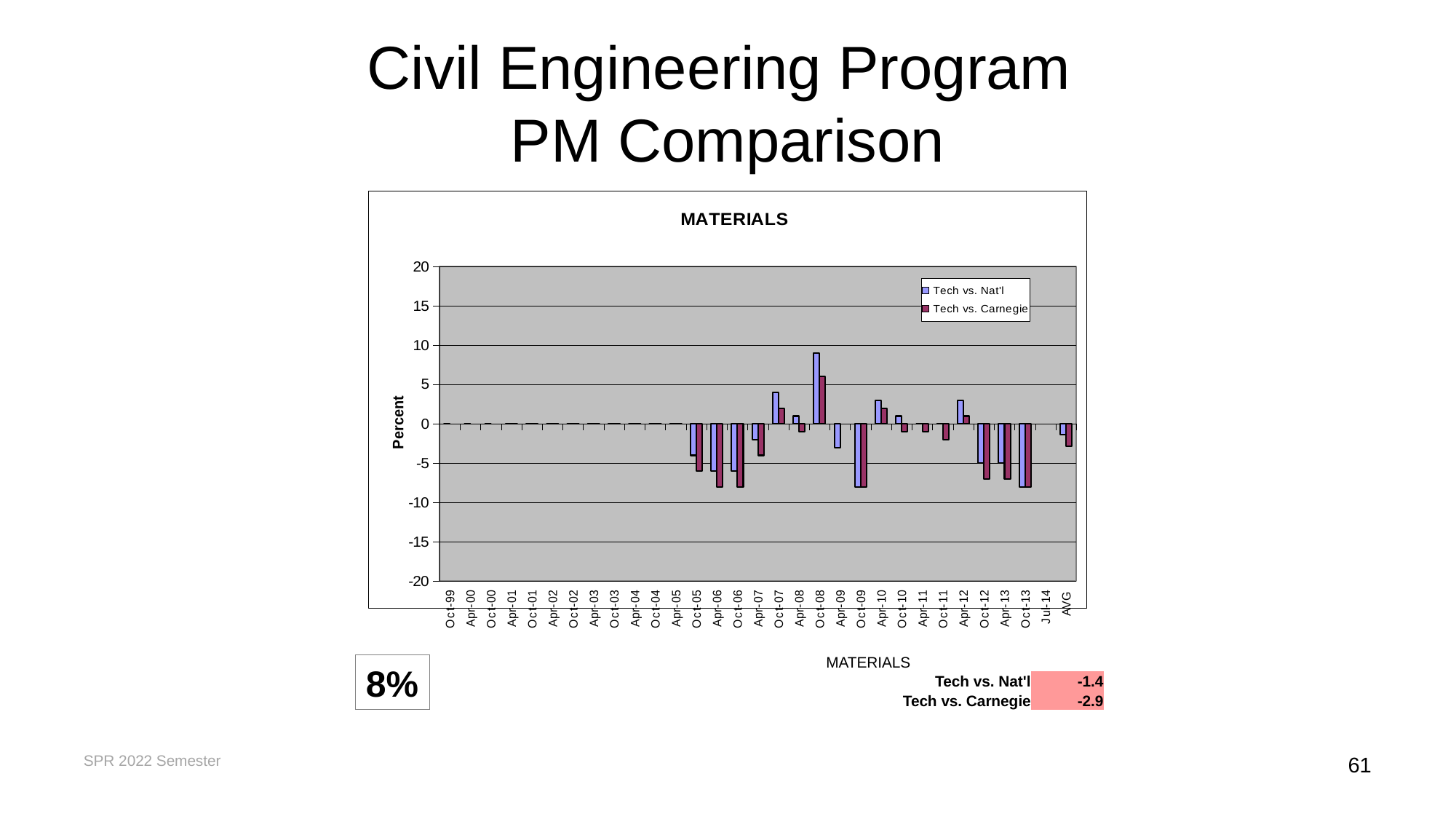
What is the AVG value for Tech vs. Nat'l shown on the slide? -1.4 How many series does the chart legend list? 2 What is the AVG value for Tech vs. Carnegie shown on the slide? -2.9 What kind of chart is shown on the slide? bar chart Is the Tech vs. Nat'l value for Oct-09 greater or less than -5? less Is the Tech vs. Carnegie value for Apr-06 greater or less than -5? less What is the label on the vertical axis of the chart? Percent For Oct-08, which is larger: Tech vs. Nat'l or Tech vs. Carnegie? Tech vs. Nat'l Which period has the highest Tech vs. Nat'l value? Oct-08 Is the Tech vs. Nat'l value for Oct-08 greater or less than 5? greater For Apr-06, which is larger: Tech vs. Nat'l or Tech vs. Carnegie? Tech vs. Nat'l What is the title of the chart? MATERIALS